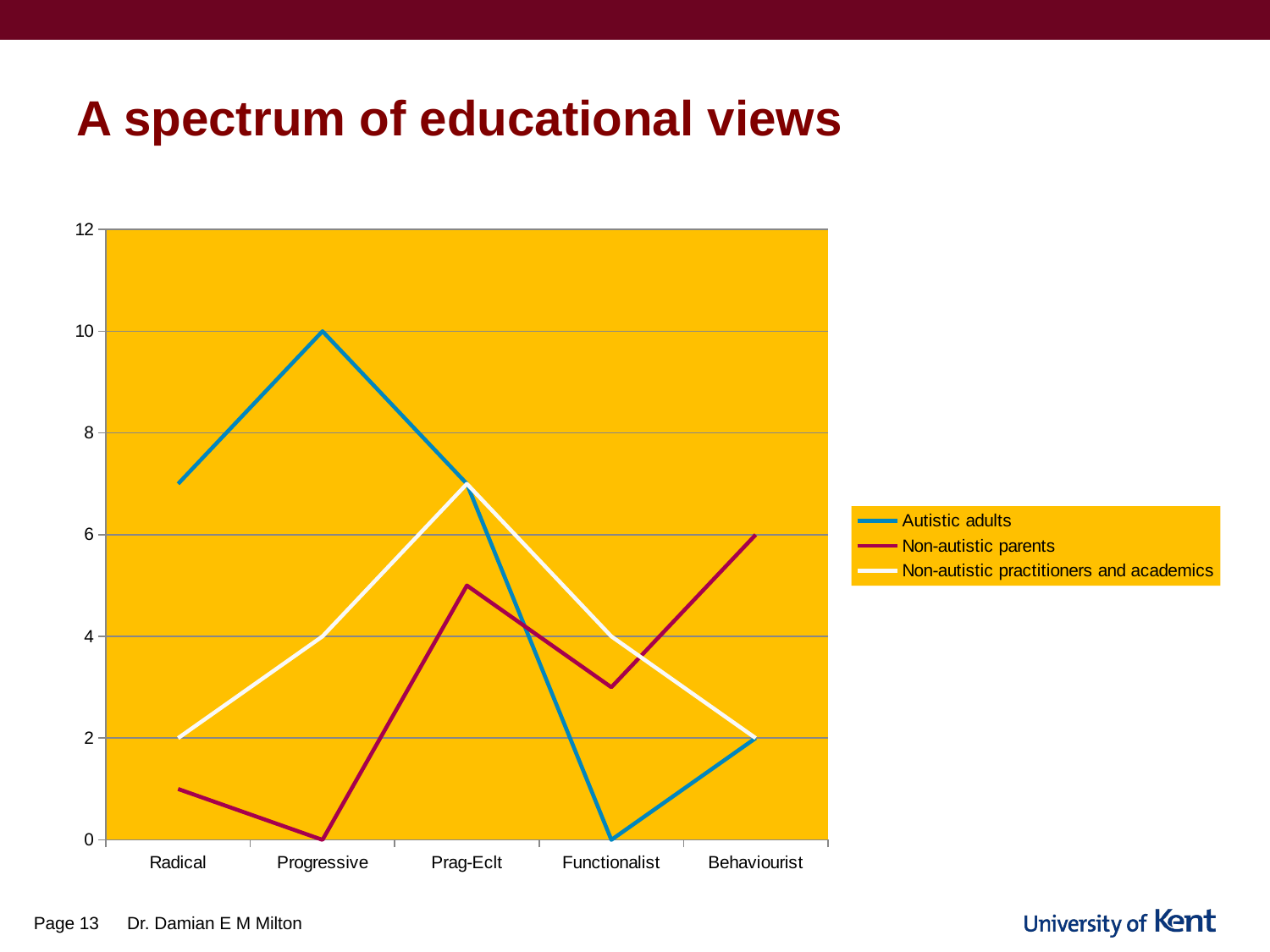
What kind of chart is shown on the slide? line chart At which category is the Non-autistic parents series lowest? Progressive What is the value for Non-autistic practitioners and academics at Progressive? 4 At which category is the Autistic adults series highest? Progressive Which is larger at Functionalist: Non-autistic parents or Non-autistic practitioners and academics? Non-autistic practitioners and academics Is the value for Autistic adults at Radical greater or less than 6? greater How many series does the legend list? 3 What is the value for Autistic adults at Functionalist? 0 What is the value for Non-autistic parents at Behaviourist? 6 What is the value for Autistic adults at Progressive? 10 How many categories are shown on the x axis? 5 What is the difference between Autistic adults at Progressive and Autistic adults at Behaviourist? 8